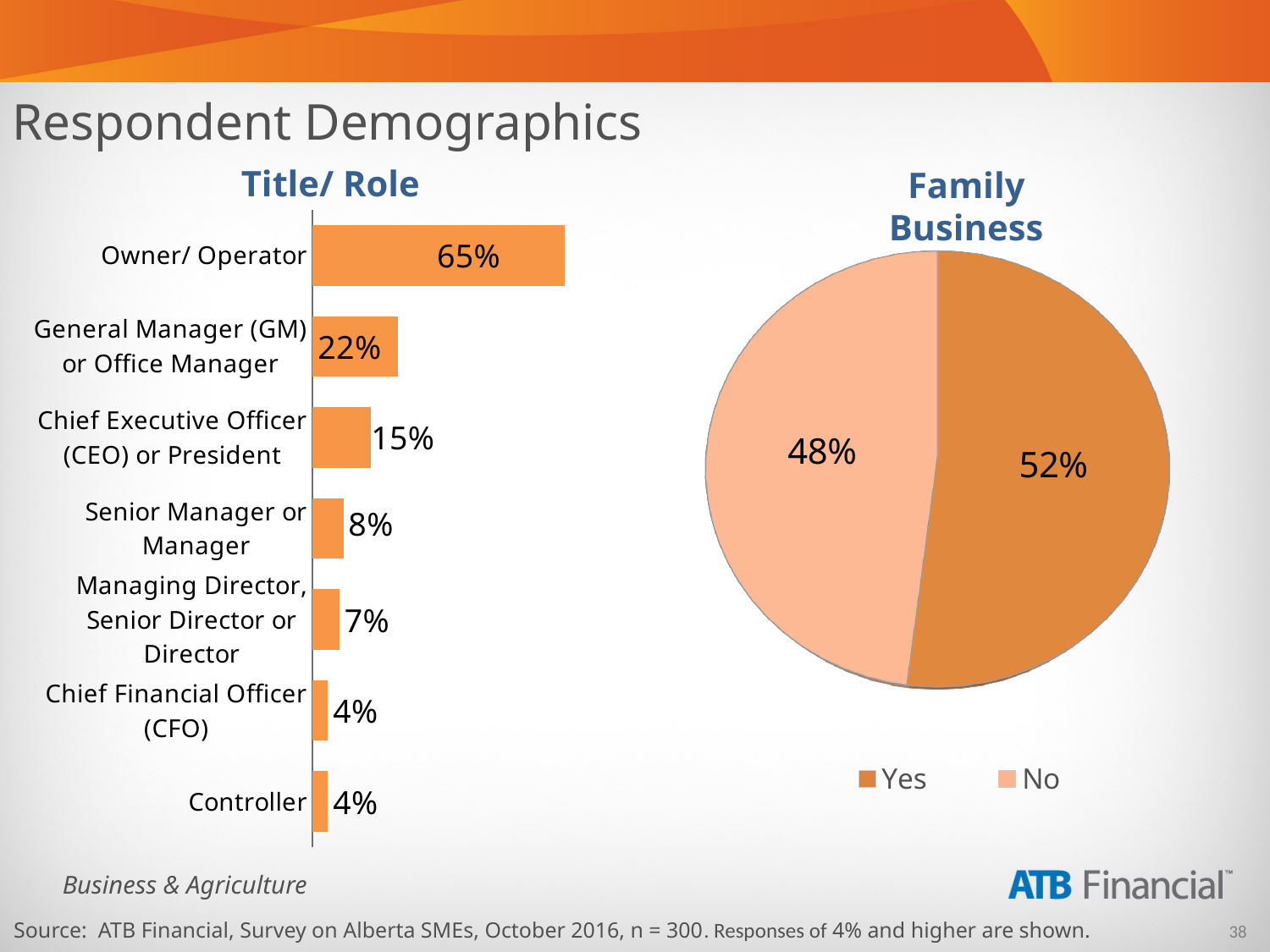
In the Title/ Role chart, what is the difference between Owner/ Operator and General Manager (GM) or Office Manager? 43% In the Title/ Role chart, which role has the highest percentage? Owner/ Operator In the Title/ Role chart, what is the value for Chief Executive Officer (CEO) or President? 15% What kind of chart is the Title/ Role chart? Bar chart How many roles are shown in the Title/ Role chart? 7 In the Family Business chart, what share of respondents answered Yes? 52% In the Title/ Role chart, what is the value for Senior Manager or Manager? 8% In the Family Business chart, what share of respondents answered No? 48% What kind of chart is the Family Business chart? Pie chart How many entries does the legend of the Family Business chart list? 2 In the Title/ Role chart, what percentage of respondents are Owner/ Operator? 65% In the Title/ Role chart, which is larger: General Manager (GM) or Office Manager, or Chief Executive Officer (CEO) or President? General Manager (GM) or Office Manager